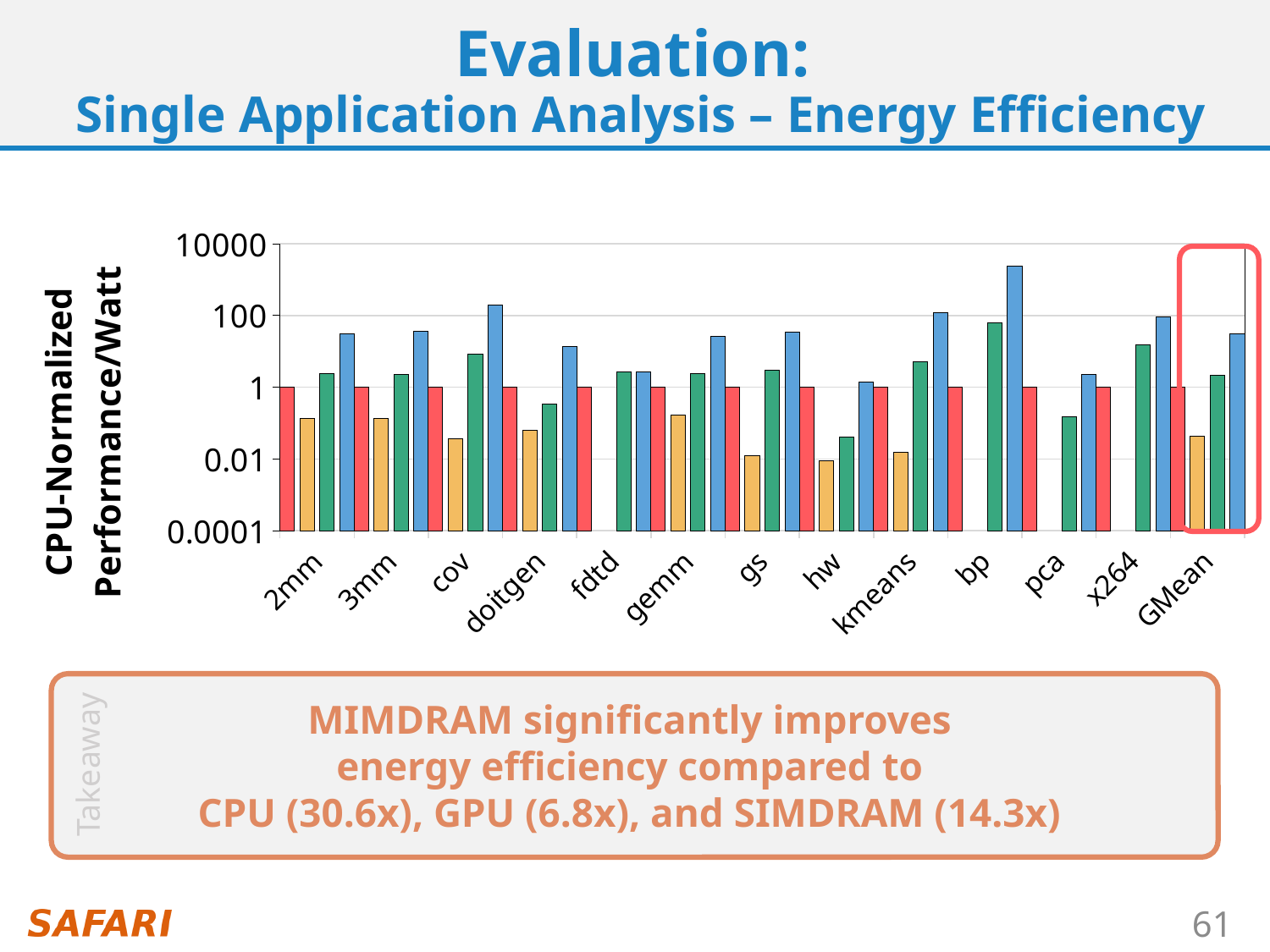
Is the value of the yellow bar for 2mm greater or less than 0.01? greater For hw, which is larger: the red bar or the green bar? the red bar What is the value of the red bar for 2mm? 1 What is the label of the y axis of the chart? CPU-Normalized Performance/Watt Which category has the highest blue bar? bp Which category on the x axis is highlighted with a red rounded box? GMean Is the value of the green bar for hw greater or less than 1? less Is the value of the blue bar for 2mm greater or less than 100? less What type of chart is shown on the slide? bar chart For bp, which is larger: the blue bar or the green bar? the blue bar How many application categories are shown on the x axis of the chart? 13